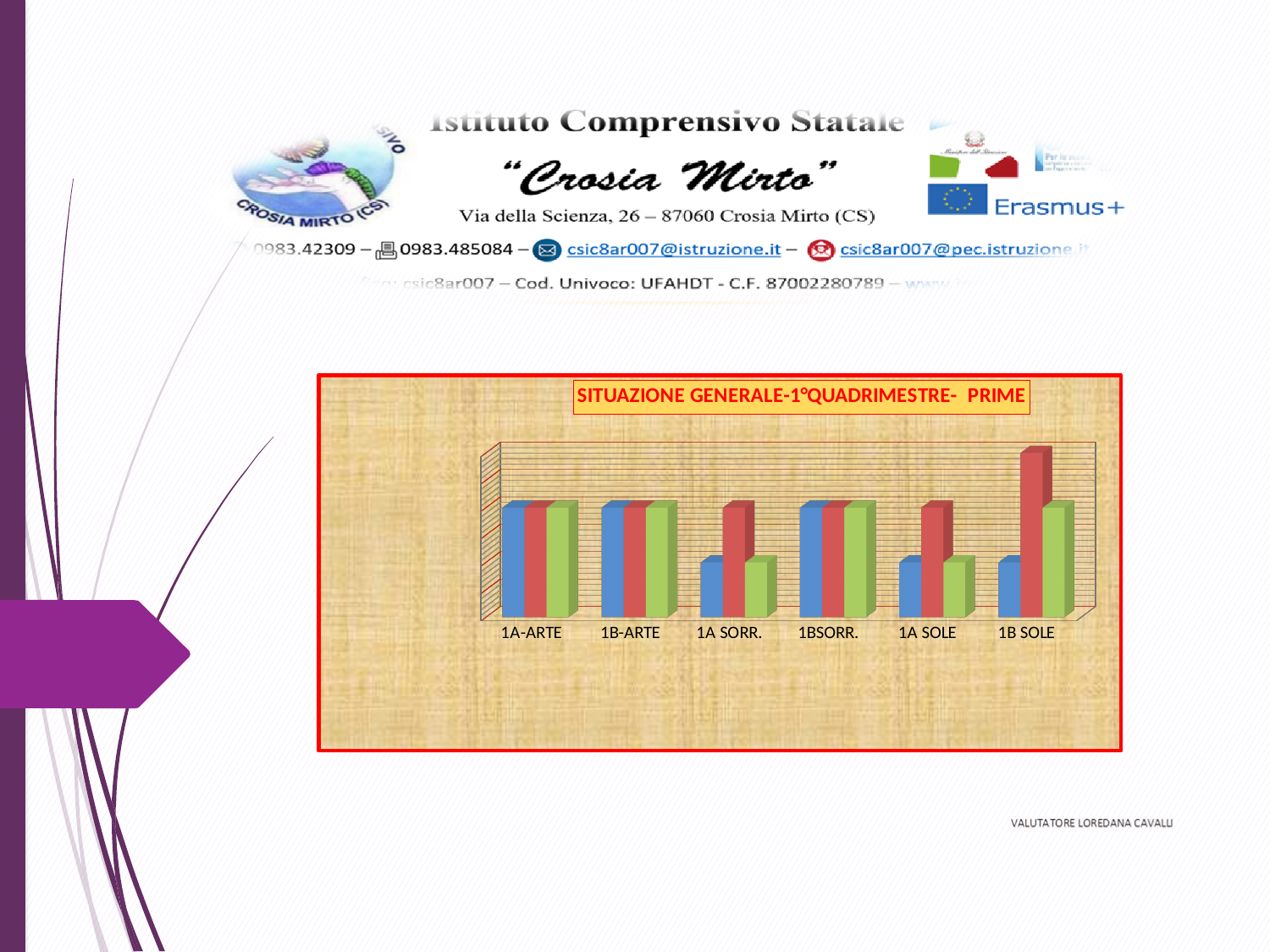
What colours are the three bars in each category of the chart? blue, red and green Which category has the tallest red bar in the chart? 1B SOLE Is the blue bar for 1A-ARTE taller or shorter than the blue bar for 1A SORR.? taller Is the green bar for 1A SOLE taller or shorter than the green bar for 1B SOLE? shorter Which category contains the tallest bar overall in the chart? 1B SOLE How many categories are shown on the x axis of the chart? 6 In the 1B SOLE category, which coloured bar is the tallest? red What kind of chart is shown on the slide? bar chart How many bars are plotted for each category in the chart? 3 What is the title of the chart? SITUAZIONE GENERALE-1°QUADRIMESTRE- PRIME